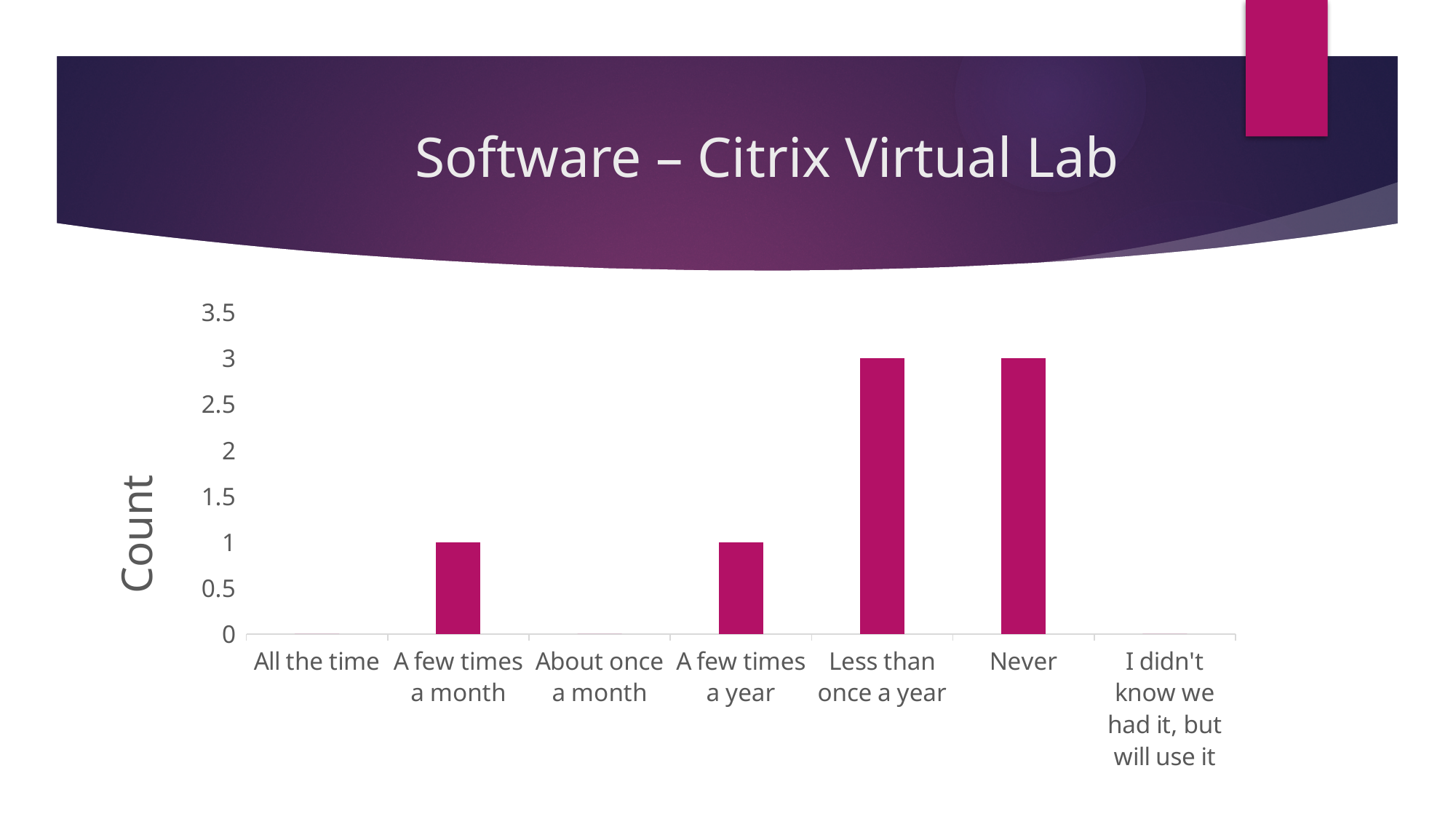
How many categories are shown on the x axis? 7 What is the difference between the count for "Never" and the count for "A few times a month"? 2 Which has a higher count, "Less than once a year" or "A few times a year"? Less than once a year Is the count for "A few times a year" greater or less than 2? less Is the count for "Never" greater or less than 2? greater What kind of chart is shown on the slide? bar chart What is the count for "A few times a year"? 1 What is the count for "Less than once a year"? 3 What is the count for "All the time"? 0 What is the count for "A few times a month"? 1 What is the label of the vertical axis? Count What is the count for "Never"? 3